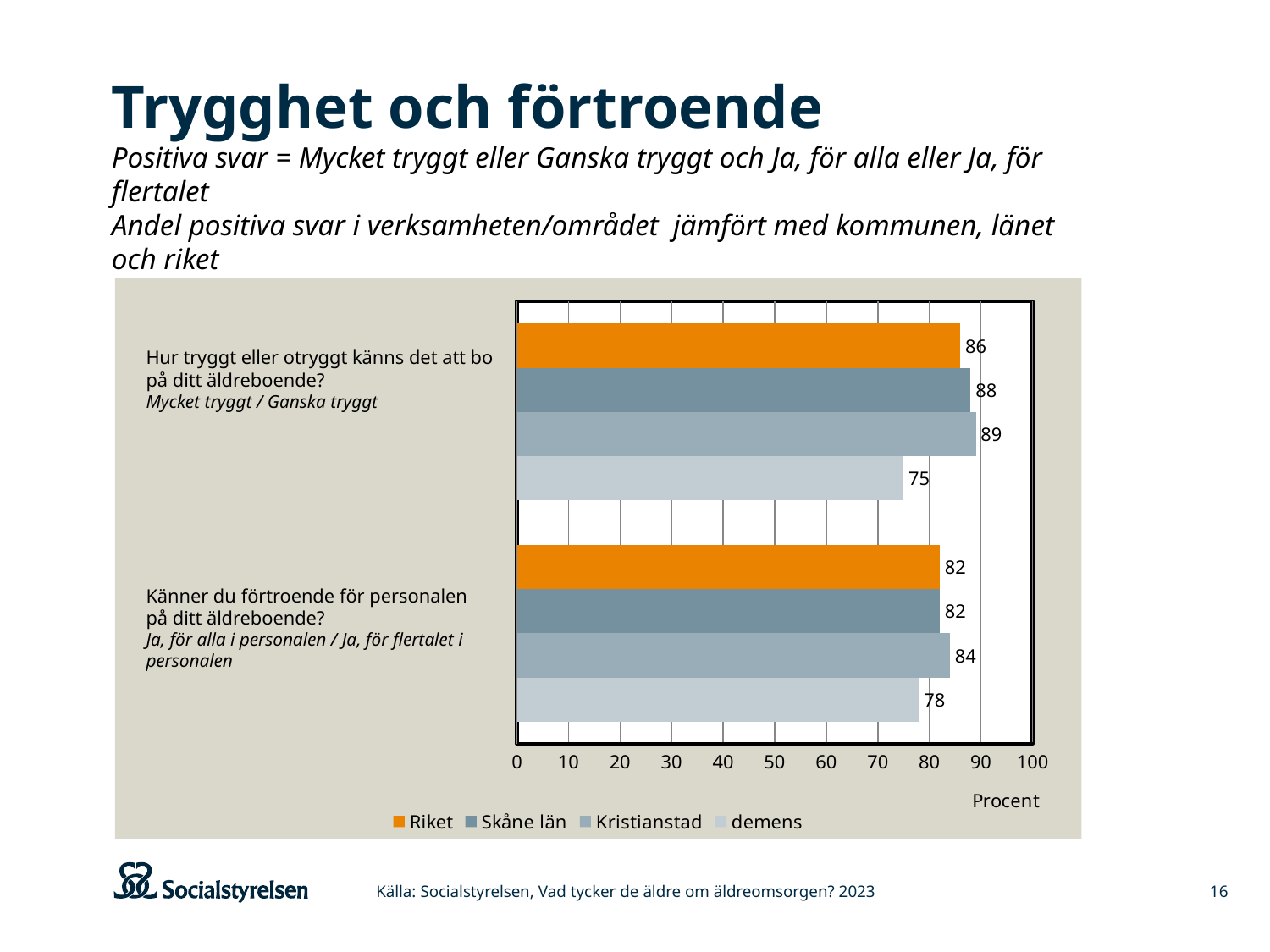
What is the difference between the Kristianstad value and the demens value on the question "Hur tryggt eller otryggt känns det att bo på ditt äldreboende?"? 14 Is the demens value for "Hur tryggt eller otryggt känns det att bo på ditt äldreboende?" greater or less than 80? less How many series does the legend list? 4 What value is shown for Riket on the question "Hur tryggt eller otryggt känns det att bo på ditt äldreboende?"? 86 What value is shown for Skåne län on the question "Känner du förtroende för personalen på ditt äldreboende?"? 82 What value is shown for Kristianstad on the question "Hur tryggt eller otryggt känns det att bo på ditt äldreboende?"? 89 Which series has the highest value on the question "Känner du förtroende för personalen på ditt äldreboende?"? Kristianstad Which series has the lowest value on the question "Hur tryggt eller otryggt känns det att bo på ditt äldreboende?"? demens Which is larger: the Riket value for "Hur tryggt eller otryggt känns det att bo på ditt äldreboende?" or the Riket value for "Känner du förtroende för personalen på ditt äldreboende?"? Hur tryggt eller otryggt känns det att bo på ditt äldreboende? What value is shown for demens on the question "Känner du förtroende för personalen på ditt äldreboende?"? 78 What is the label on the horizontal axis of the chart? Procent What kind of chart is shown on the slide? bar chart